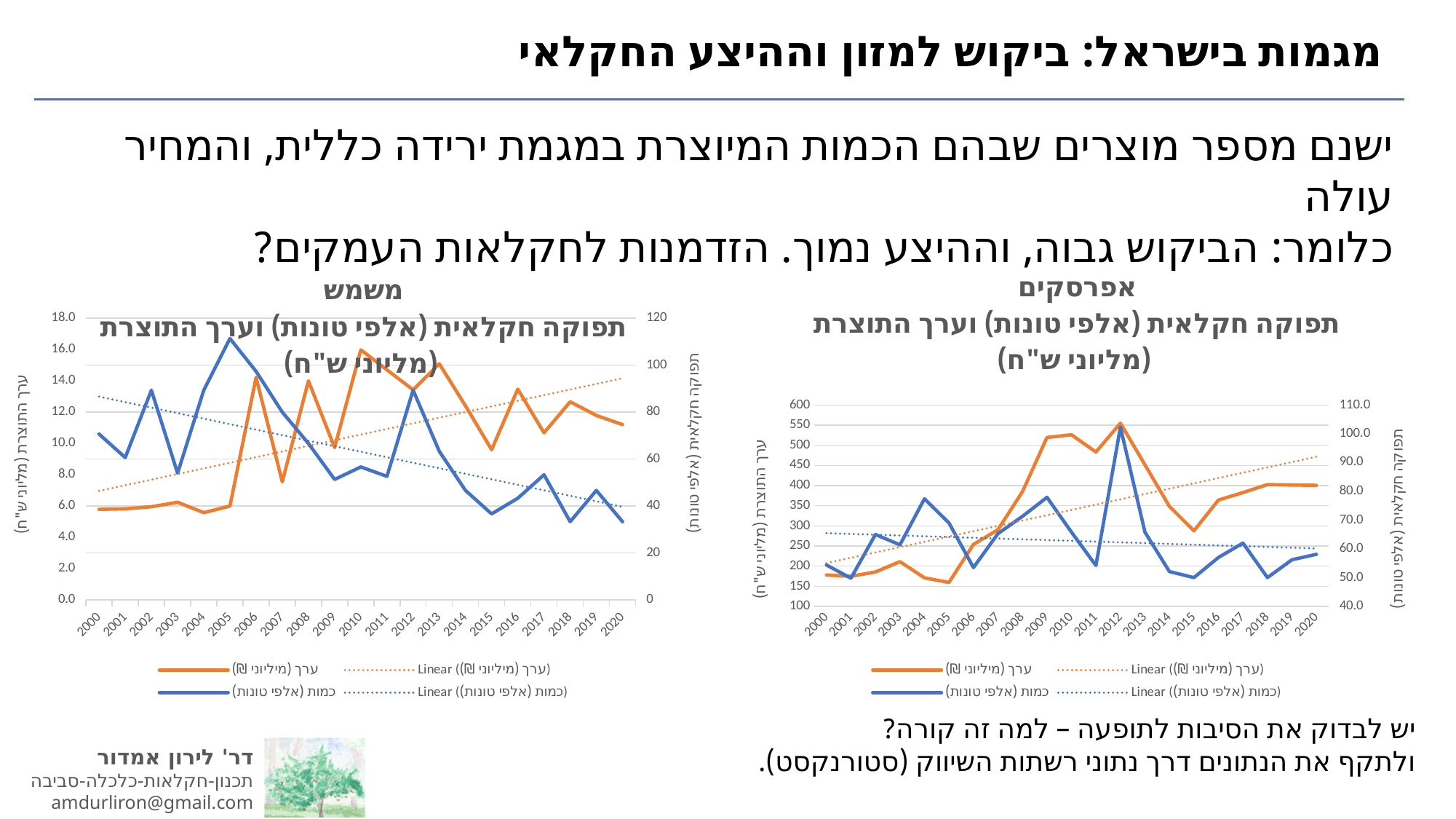
What kind of chart is the left chart titled משמש? line chart In the right chart titled אפרסקים, how many years are plotted along the x axis? 21 In the left chart titled משמש, in which year does the blue line (כמות, אלפי טונות) reach its highest value? 2005 In the left chart titled משמש, which year has the larger orange-line value, 2010 or 2015? 2010 In the left chart titled משמש, does the dotted orange linear trendline rise or fall from 2000 to 2020? rise In the right chart titled אפרסקים, does the dotted blue linear trendline rise or fall from 2000 to 2020? fall In the right chart titled אפרסקים, is the orange line's value for 2000 greater or less than 200? less In the right chart titled אפרסקים, is the orange line's value for 2012 greater or less than 500? greater In the left chart titled משמש, in which year does the orange line (ערך, מיליוני ש"ח) reach its highest value? 2010 In the right chart titled אפרסקים, in which year does the orange line (ערך, מיליוני ש"ח) reach its highest value? 2012 In the left chart titled משמש, is the orange line's value for 2010 greater or less than 14.0? greater In the left chart titled משמש, how many entries does the legend list? 4